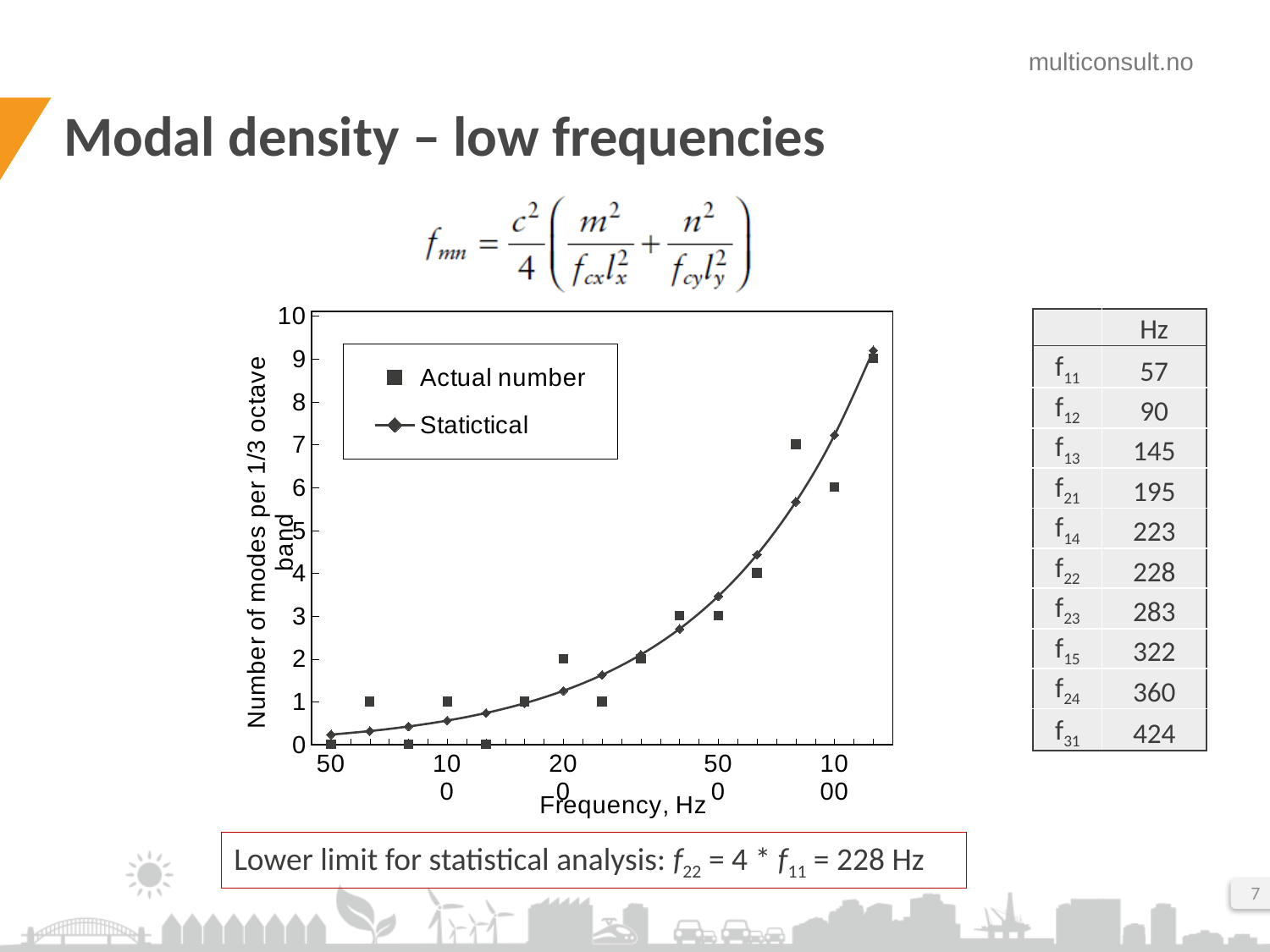
Does the Statictical curve rise or fall as frequency increases along the x axis? rise What is the Actual number of modes at 200 Hz? 2 What are the two series named in the chart legend? Actual number and Statictical Is the Statictical value at 100 Hz greater or less than 1? less Is the Statictical value at 1000 Hz greater or less than 5? greater What is the title of the chart's x axis? Frequency, Hz What is the Actual number of modes at 50 Hz? 0 At 1000 Hz, which series shows the higher value, Actual number or Statictical? Statictical What is the highest value plotted for the Actual number series? 9 What is the Actual number of modes at 500 Hz? 3 What is the Actual number of modes at 1000 Hz? 6 How many series does the chart legend list? 2